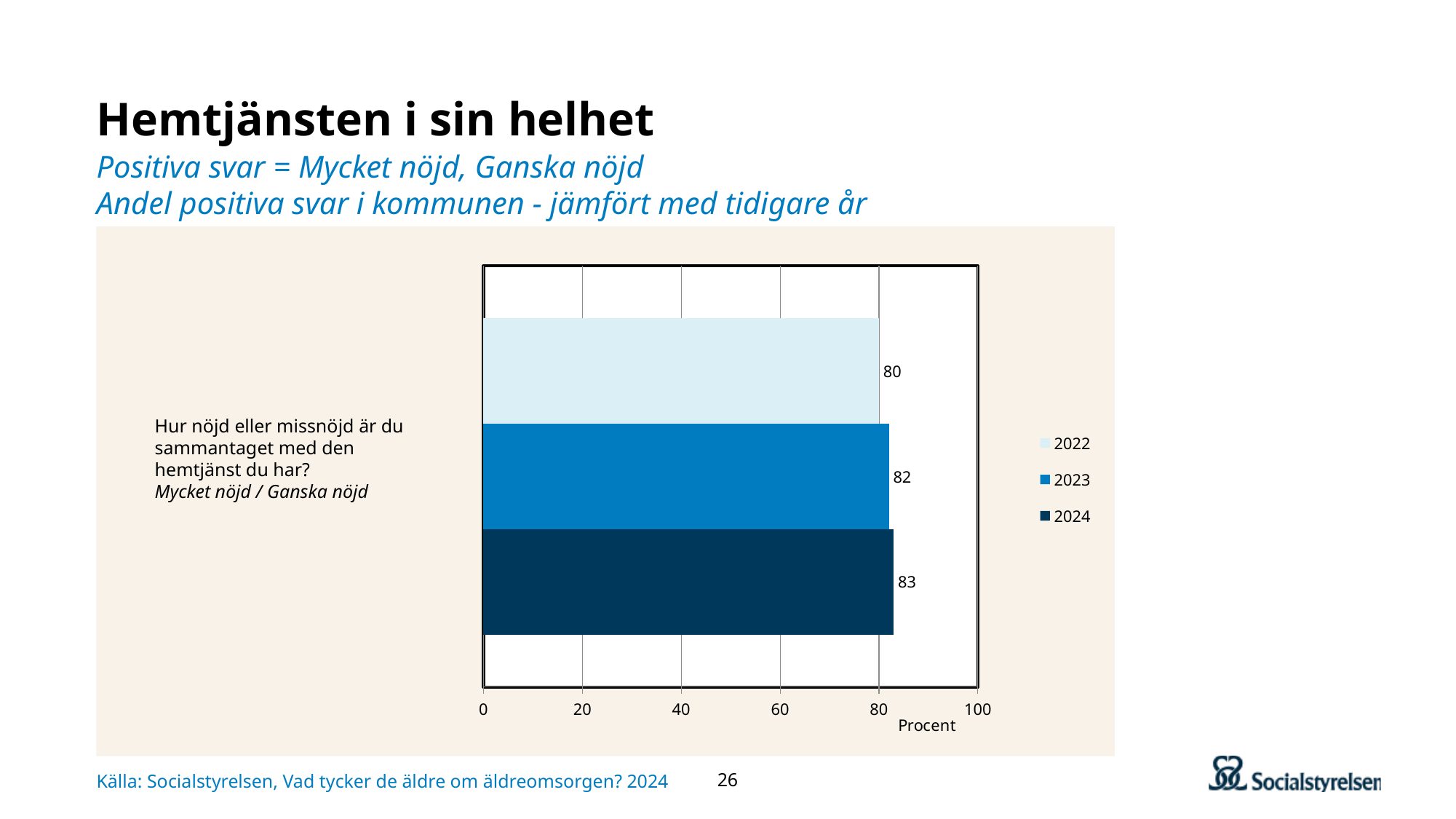
What is the value for 2022? 80 Which year has the lowest value? 2022 What kind of chart is shown? Bar chart What is the label on the horizontal axis? Procent What is the value for 2024? 83 How many series does the legend list? 3 What is the value for 2023? 82 Do the values rise or fall from 2022 to 2024? Rise What is the difference between the values for 2023 and 2022? 2 What is the difference between the values for 2024 and 2022? 3 Which is larger, the value for 2023 or the value for 2024? 2024 Which year has the highest value? 2024